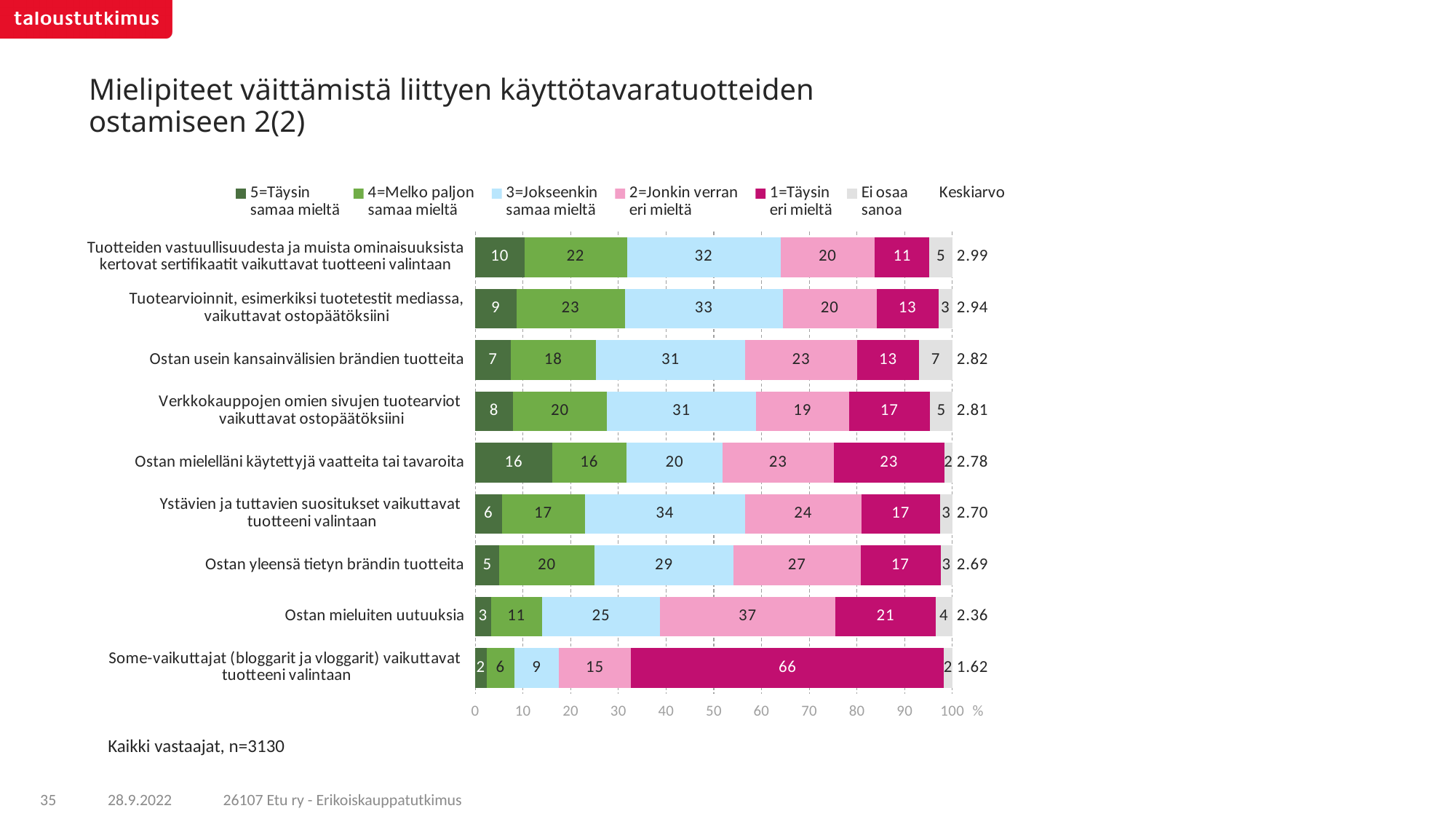
What percentage of respondents answered "1=Täysin eri mieltä" to "Some-vaikuttajat (bloggarit ja vloggarit) vaikuttavat tuotteeni valintaan"? 66 How many statements (bars) are shown in the chart? 9 What is the difference between the "2=Jonkin verran eri mieltä" share for "Ostan mieluiten uutuuksia" and for "Ostan yleensä tietyn brändin tuotteita"? 10 Which statement has the highest share of "5=Täysin samaa mieltä" responses? Ostan mielelläni käytettyjä vaatteita tai tavaroita What is the combined share of "5=Täysin samaa mieltä" and "4=Melko paljon samaa mieltä" for "Verkkokauppojen omien sivujen tuotearviot vaikuttavat ostopäätöksiini"? 28 How many response categories does the legend list? 6 Which is larger: the "4=Melko paljon samaa mieltä" share for "Tuotearvioinnit, esimerkiksi tuotetestit mediassa, vaikuttavat ostopäätöksiini" or for "Ostan usein kansainvälisten brändien tuotteita"? Tuotearvioinnit, esimerkiksi tuotetestit mediassa, vaikuttavat ostopäätöksiini What is the Keskiarvo (mean) for "Ostan mieluiten uutuuksia"? 2.36 What percentage answered "3=Jokseenkin samaa mieltä" to "Ystävien ja tuttavien suositukset vaikuttavat tuotteeni valintaan"? 34 Which statement has the lowest Keskiarvo (mean) value? Some-vaikuttajat (bloggarit ja vloggarit) vaikuttavat tuotteeni valintaan What kind of chart is shown on the slide? Stacked bar chart Which statement has the highest Keskiarvo (mean) value? Tuotteiden vastuullisuudesta ja muista ominaisuuksista kertovat sertifikaatit vaikuttavat tuotteeni valintaan